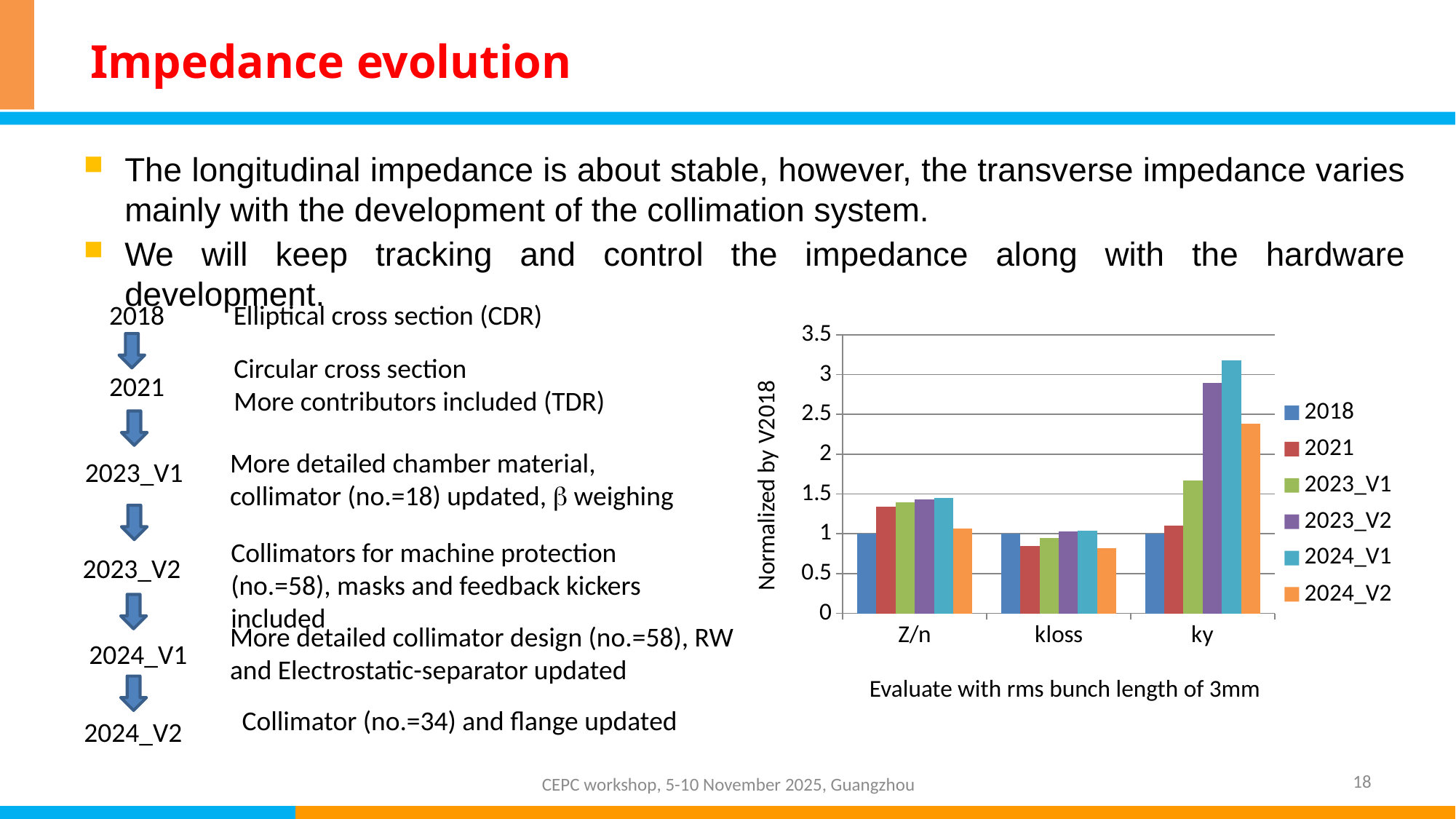
How many series does the chart legend list? 6 Which category contains the tallest bar in the chart? ky What is the value of the 2018 series for Z/n? 1 For ky, which is larger: the value for 2024_V1 or the value for 2024_V2? 2024_V1 What is the y-axis title of the chart? Normalized by V2018 What kind of chart is shown on the slide? bar chart How many categories are shown on the x axis of the chart? 3 Which series has the highest value for ky? 2024_V1 Is the value of 2023_V2 for ky greater or less than 2.5? greater Which series has the lowest value for ky? 2018 Is the value of 2024_V1 for ky greater or less than 3? greater Is the value of 2024_V2 for kloss greater or less than 1? less